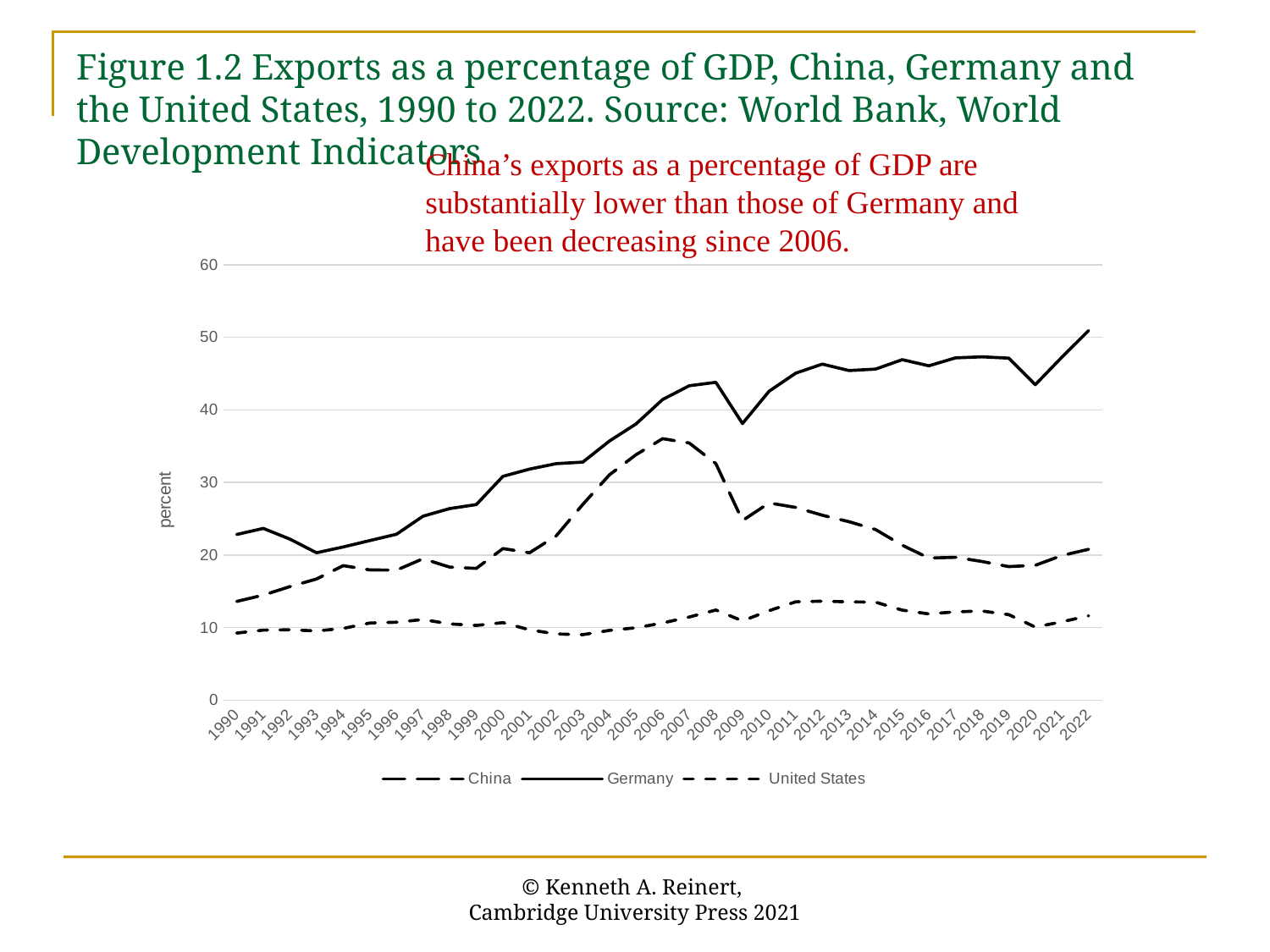
In 2006, which is larger: the value for China or the value for the United States? China Does the value for China rise or fall between 2006 and 2016? fall Is the value for China in 2006 greater or less than 30? greater Is the value for the United States in 2020 greater or less than 20? less Is the value for Germany in 2022 greater or less than 40? greater How many series does the legend list? 3 What is the label on the y axis? percent Which country has the highest exports as a percentage of GDP in 2022? Germany How many years are plotted along the x axis? 33 What kind of chart is shown on the slide? line chart Which country has the lowest exports as a percentage of GDP in 2010? United States